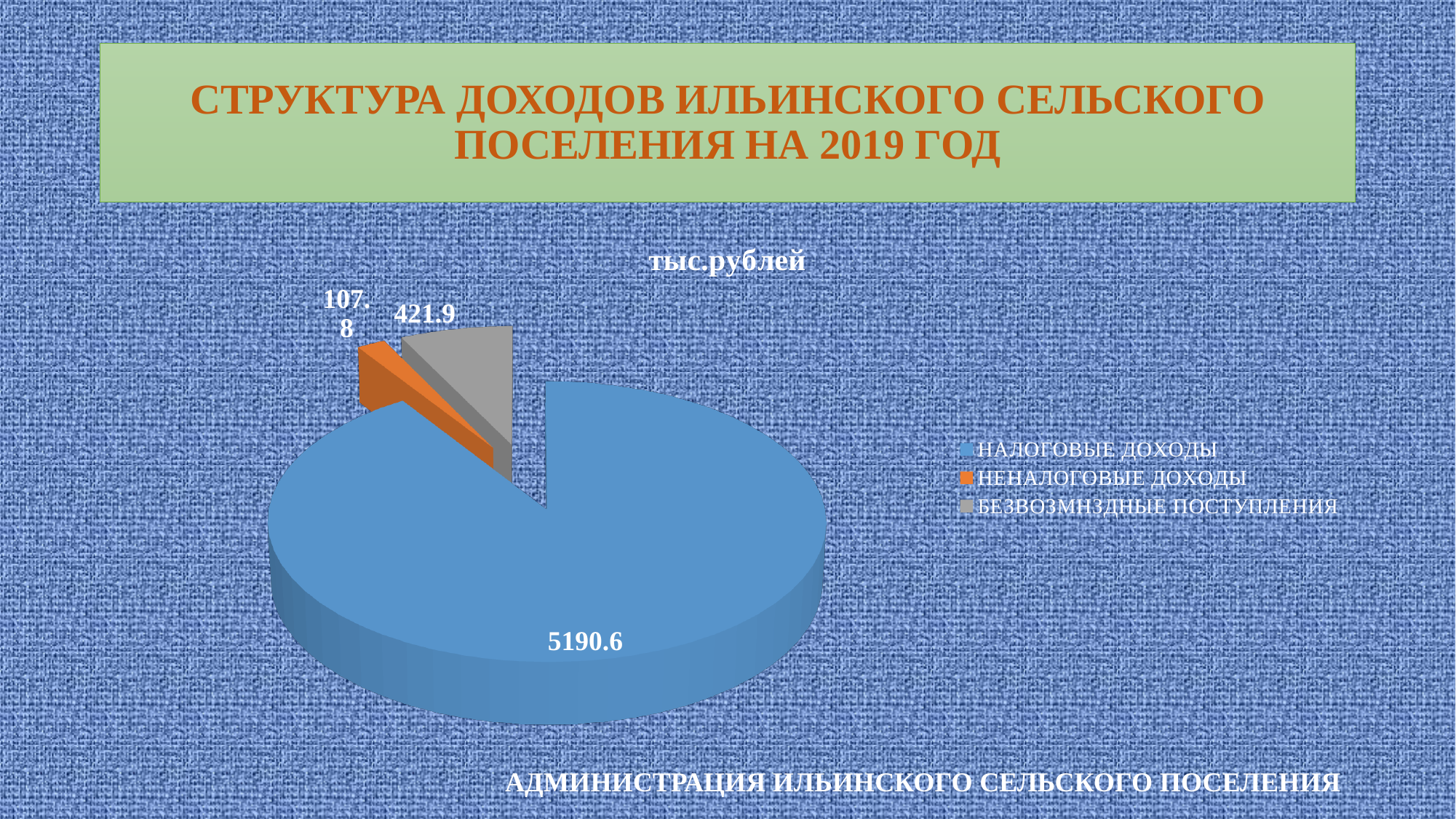
What is the value for НЕНАЛОГОВЫЕ ДОХОДЫ? 107.8 What colour is the slice for НЕНАЛОГОВЫЕ ДОХОДЫ? Orange What is the value for НАЛОГОВЫЕ ДОХОДЫ? 5190.6 Which category has the smallest slice of the pie? НЕНАЛОГОВЫЕ ДОХОДЫ Which category has the largest slice of the pie? НАЛОГОВЫЕ ДОХОДЫ What type of chart is shown on the slide? Pie chart What is the difference between the values for БЕЗВОЗМНЗДНЫЕ ПОСТУПЛЕНИЯ and НЕНАЛОГОВЫЕ ДОХОДЫ? 314.1 Which is larger, the value for БЕЗВОЗМНЗДНЫЕ ПОСТУПЛЕНИЯ or the value for НЕНАЛОГОВЫЕ ДОХОДЫ? БЕЗВОЗМНЗДНЫЕ ПОСТУПЛЕНИЯ How many slices does the pie chart have? 3 What is the difference between the values for НАЛОГОВЫЕ ДОХОДЫ and БЕЗВОЗМНЗДНЫЕ ПОСТУПЛЕНИЯ? 4768.7 What is the title of the chart? тыс.рублей What is the value for БЕЗВОЗМНЗДНЫЕ ПОСТУПЛЕНИЯ? 421.9